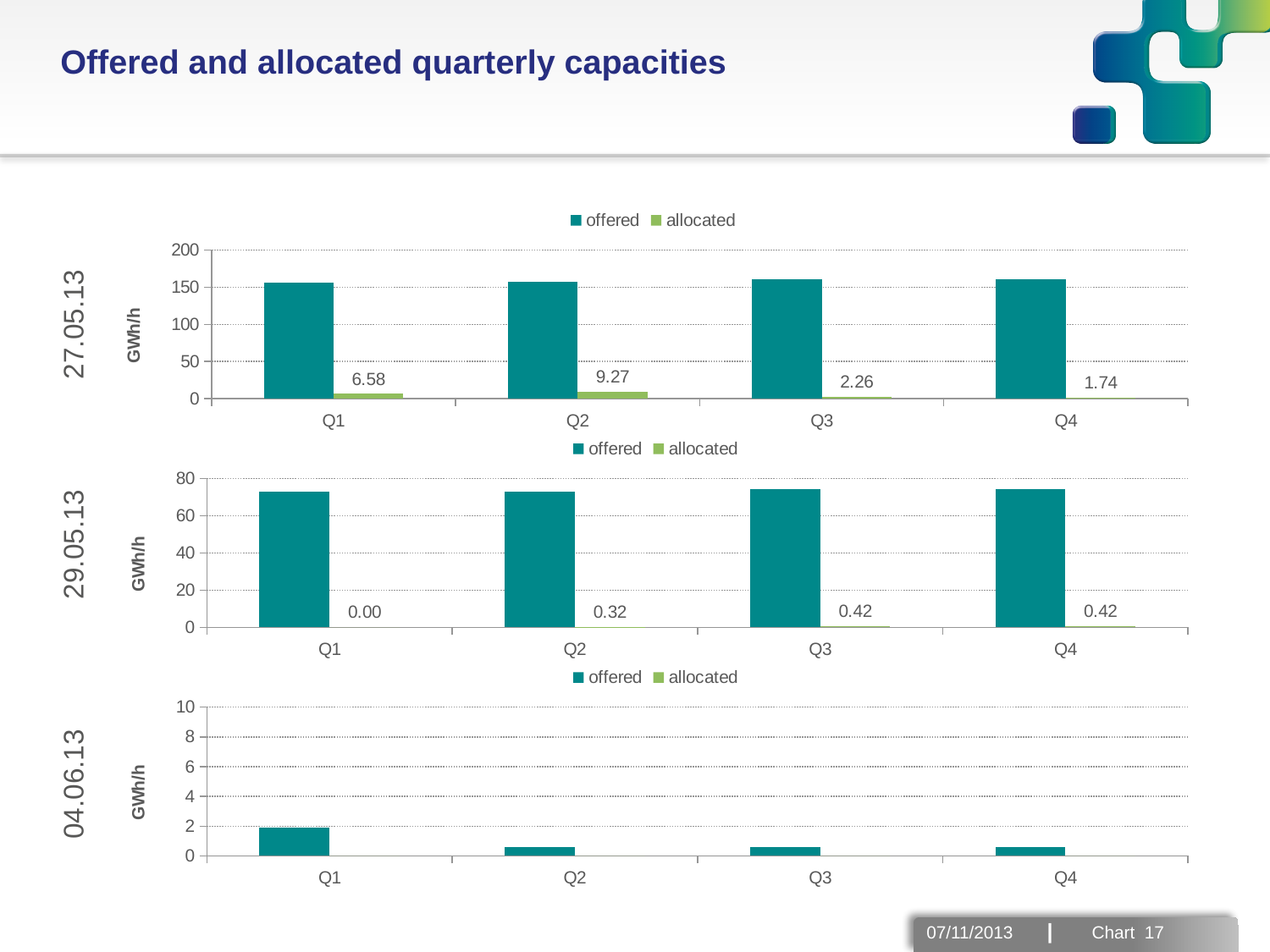
How many series does the legend of the 29.05.13 chart list? 2 In the 04.06.13 chart, which quarter has the highest offered value? Q1 In the 29.05.13 chart, is the offered value for Q1 greater or less than 60? greater In the 04.06.13 chart, is the offered value for Q3 greater or less than 2? less In the 27.05.13 chart, what is the allocated value for Q4? 1.74 In the 27.05.13 chart, which quarter has the lowest allocated value? Q4 In the 27.05.13 chart, what is the allocated value for Q2? 9.27 In the 29.05.13 chart, what is the allocated value for Q3? 0.42 In the 27.05.13 chart, is the offered value for Q3 greater or less than 150? greater In the 27.05.13 chart, which quarter has the highest allocated value? Q2 In the 27.05.13 chart, what is the difference between the allocated values for Q2 and Q1? 2.69 In the 29.05.13 chart, which quarter has the lowest allocated value? Q1